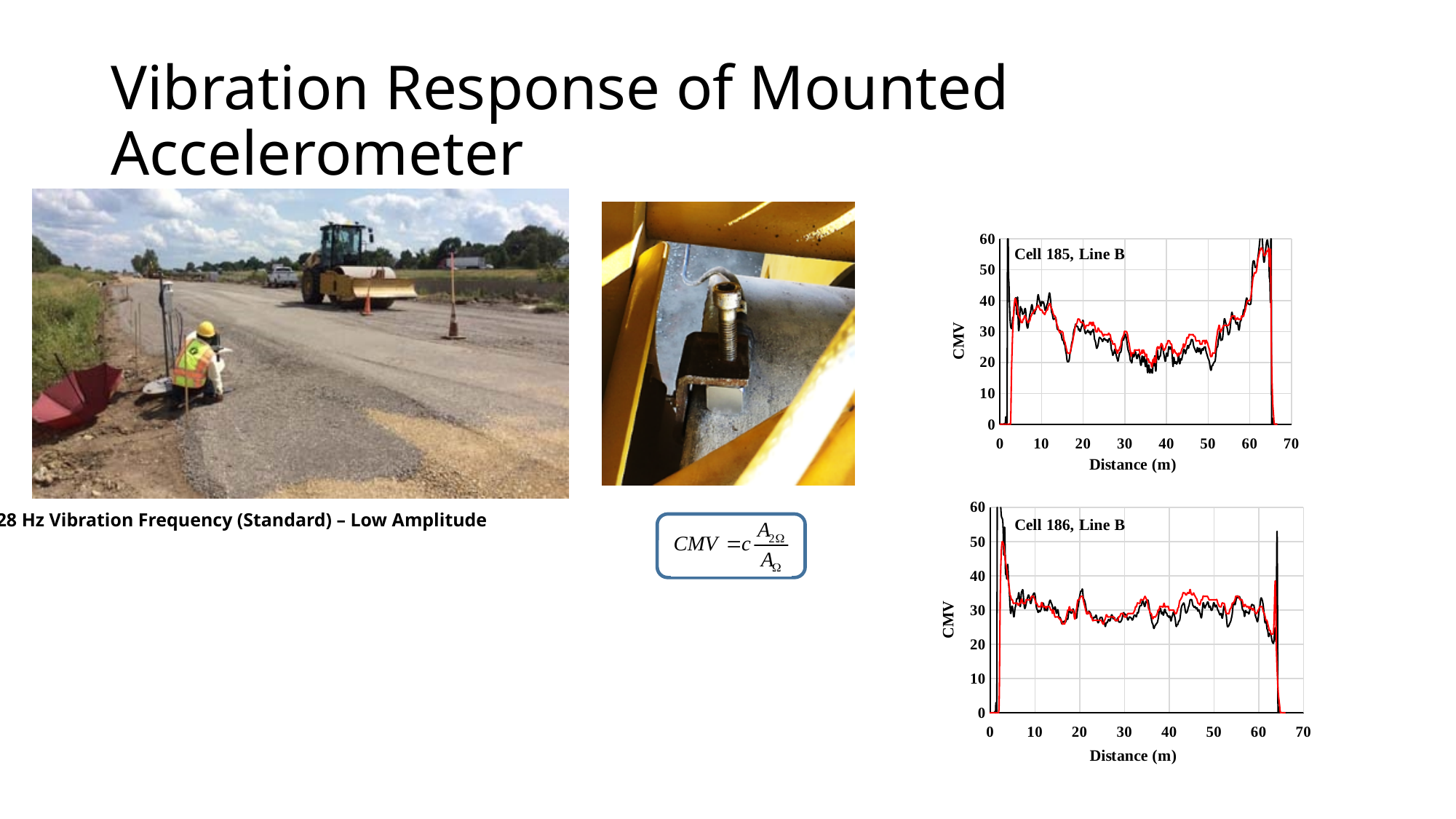
What is the x-axis label on the 'Cell 186, Line B' chart? Distance (m) What kind of chart is the 'Cell 185, Line B' chart? line chart In the 'Cell 186, Line B' chart, is the CMV value at a distance of 30 m greater or less than 40? less In the 'Cell 185, Line B' chart, is the CMV value at a distance of 10 m greater or less than 30? greater In the 'Cell 185, Line B' chart, do the CMV values rise or fall between 50 m and 65 m? rise What is the y-axis label on the 'Cell 185, Line B' chart? CMV In the 'Cell 186, Line B' chart, is the CMV value at a distance of 10 m greater or less than 20? greater What is the highest value shown on the y-axis of the 'Cell 186, Line B' chart? 60 How many lines are plotted on the 'Cell 186, Line B' chart? 2 In the 'Cell 185, Line B' chart, do the CMV values rise or fall between 10 m and 35 m? fall